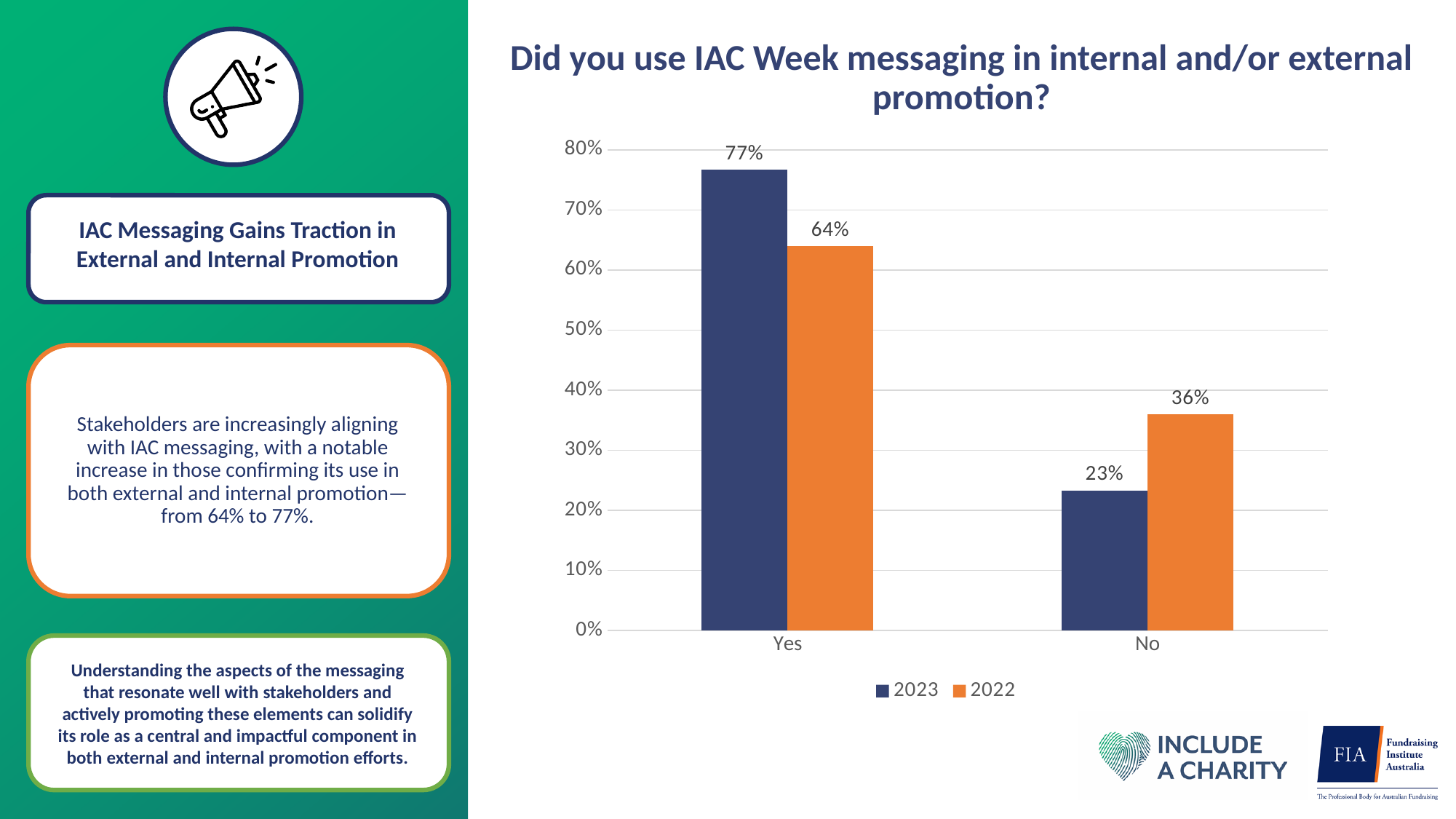
Which category has the lowest value for the 2022 series? No What percentage of respondents answered No in 2022? 36% What percentage of respondents answered Yes in 2023? 77% What percentage of respondents answered Yes in 2022? 64% What percentage of respondents answered No in 2023? 23% What is the difference between the 2022 and 2023 values for No? 13% How many series does the legend list? 2 Which is larger for the No category: the 2023 value or the 2022 value? 2022 What kind of chart is shown on the slide? Bar chart Which category has the highest value for the 2023 series? Yes What is the difference between the 2023 and 2022 values for Yes? 13% What is the title of the chart? Did you use IAC Week messaging in internal and/or external promotion?